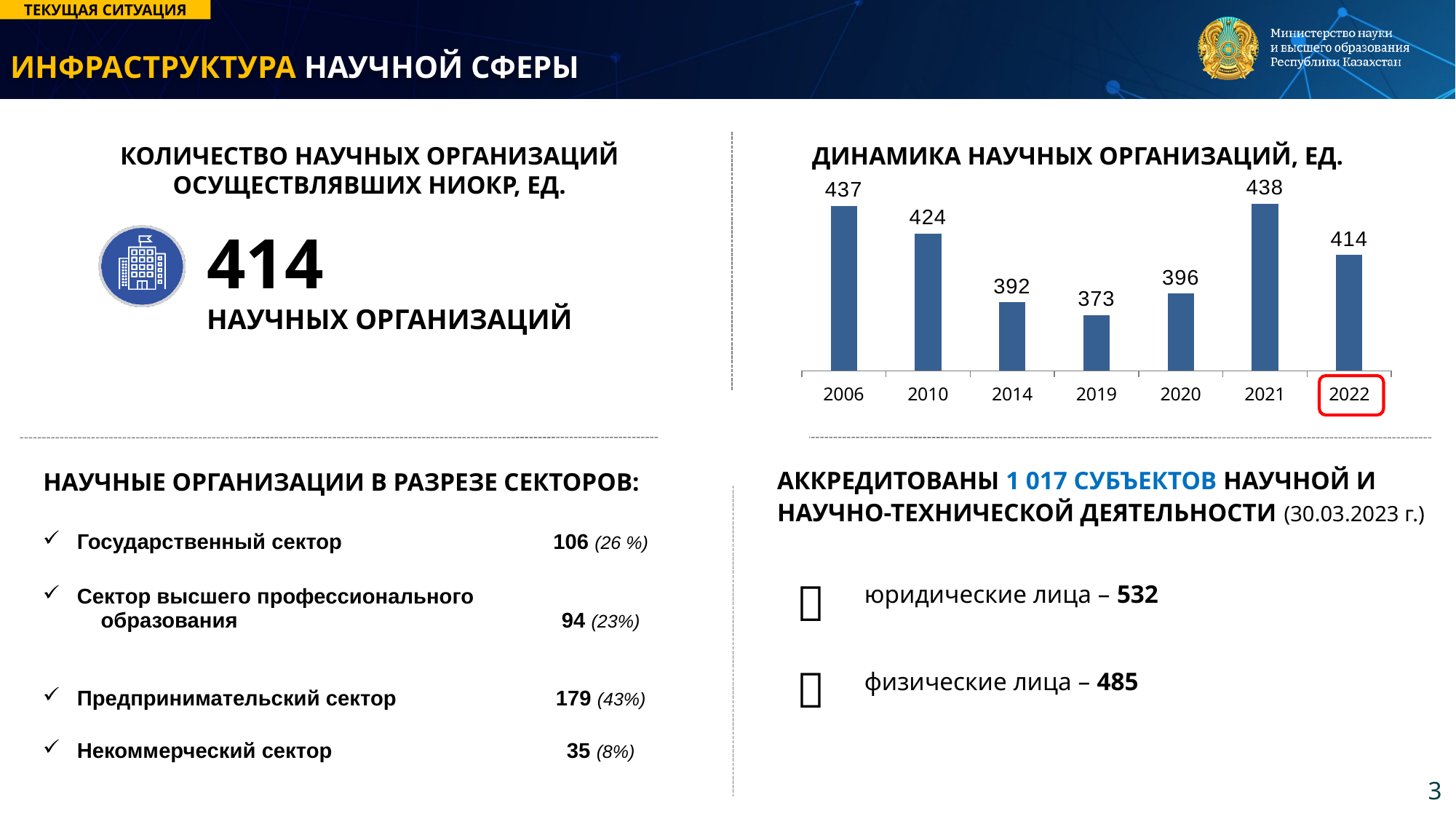
How many years are shown in the chart "ДИНАМИКА НАУЧНЫХ ОРГАНИЗАЦИЙ, ЕД."? 7 What is the value for 2022 in the chart "ДИНАМИКА НАУЧНЫХ ОРГАНИЗАЦИЙ, ЕД."? 414 What is the difference between the values for 2021 and 2022 in the chart "ДИНАМИКА НАУЧНЫХ ОРГАНИЗАЦИЙ, ЕД."? 24 Which year has the highest value in the chart "ДИНАМИКА НАУЧНЫХ ОРГАНИЗАЦИЙ, ЕД."? 2021 What is the difference between the values for 2006 and 2019 in the chart "ДИНАМИКА НАУЧНЫХ ОРГАНИЗАЦИЙ, ЕД."? 64 Which year has the lowest value in the chart "ДИНАМИКА НАУЧНЫХ ОРГАНИЗАЦИЙ, ЕД."? 2019 What is the value for 2019 in the chart "ДИНАМИКА НАУЧНЫХ ОРГАНИЗАЦИЙ, ЕД."? 373 In the chart "ДИНАМИКА НАУЧНЫХ ОРГАНИЗАЦИЙ, ЕД.", which is larger, the value for 2010 or the value for 2020? 2010 What is the value for 2006 in the chart "ДИНАМИКА НАУЧНЫХ ОРГАНИЗАЦИЙ, ЕД."? 437 Which year is highlighted with a red box on the x axis of the chart "ДИНАМИКА НАУЧНЫХ ОРГАНИЗАЦИЙ, ЕД."? 2022 In the chart "ДИНАМИКА НАУЧНЫХ ОРГАНИЗАЦИЙ, ЕД.", do the values rise or fall from 2019 to 2021? Rise What kind of chart is "ДИНАМИКА НАУЧНЫХ ОРГАНИЗАЦИЙ, ЕД."? Bar chart